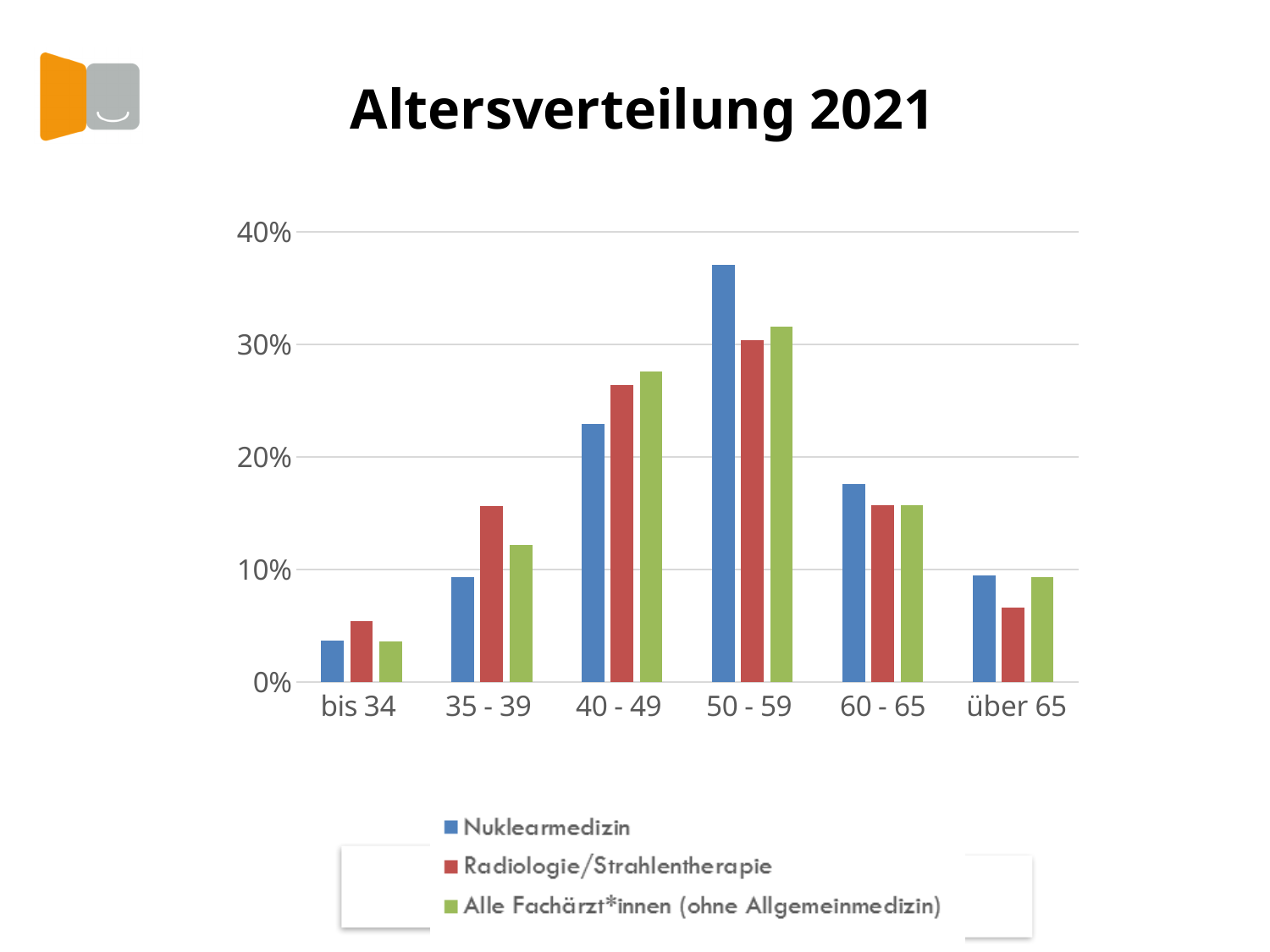
What colour represents the Nuklearmedizin series? blue In the 35 - 39 category, which is larger: Nuklearmedizin or Radiologie/Strahlentherapie? Radiologie/Strahlentherapie What is the title of the chart? Altersverteilung 2021 In the 50 - 59 category, which is larger: Nuklearmedizin or Alle Fachärzt*innen (ohne Allgemeinmedizin)? Nuklearmedizin Is the value for Alle Fachärzt*innen (ohne Allgemeinmedizin) in the 40 - 49 category greater or less than 20%? greater How many series does the legend list? 3 How many age categories are shown on the x axis? 6 Is the value for Radiologie/Strahlentherapie in the 35 - 39 category greater or less than 20%? less Is the value for Nuklearmedizin in the 50 - 59 category greater or less than 30%? greater Which age category has the highest value for Nuklearmedizin? 50 - 59 Which age category has the lowest value for Radiologie/Strahlentherapie? bis 34 What kind of chart is shown on the slide? bar chart